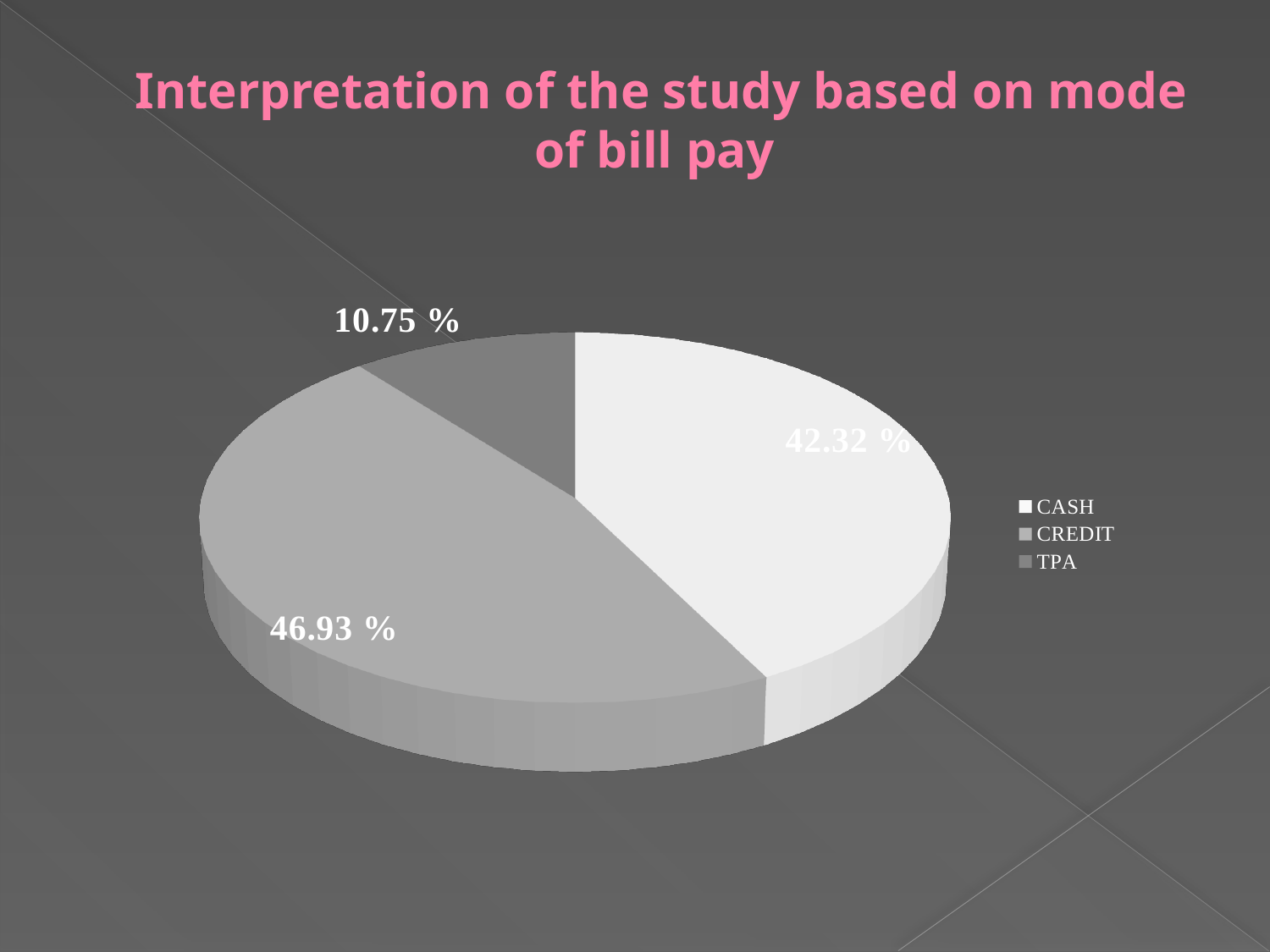
Which mode of bill pay has the largest share of the pie? CREDIT How many entries does the legend list? 3 What is the title of the slide containing the pie chart? Interpretation of the study based on mode of bill pay Which mode of bill pay has the smallest share of the pie? TPA What is the difference in percentage points between the CREDIT and CASH slices? 4.61 What percentage of the pie is labelled for CASH? 42.32 % What is the difference in percentage points between the CASH and TPA slices? 31.57 What percentage of the pie is labelled for TPA? 10.75 % Which is larger, the share for CASH or the share for TPA? CASH What kind of chart is shown on the slide? Pie chart How many slices does the pie chart have? 3 What percentage of the pie is labelled for CREDIT? 46.93 %